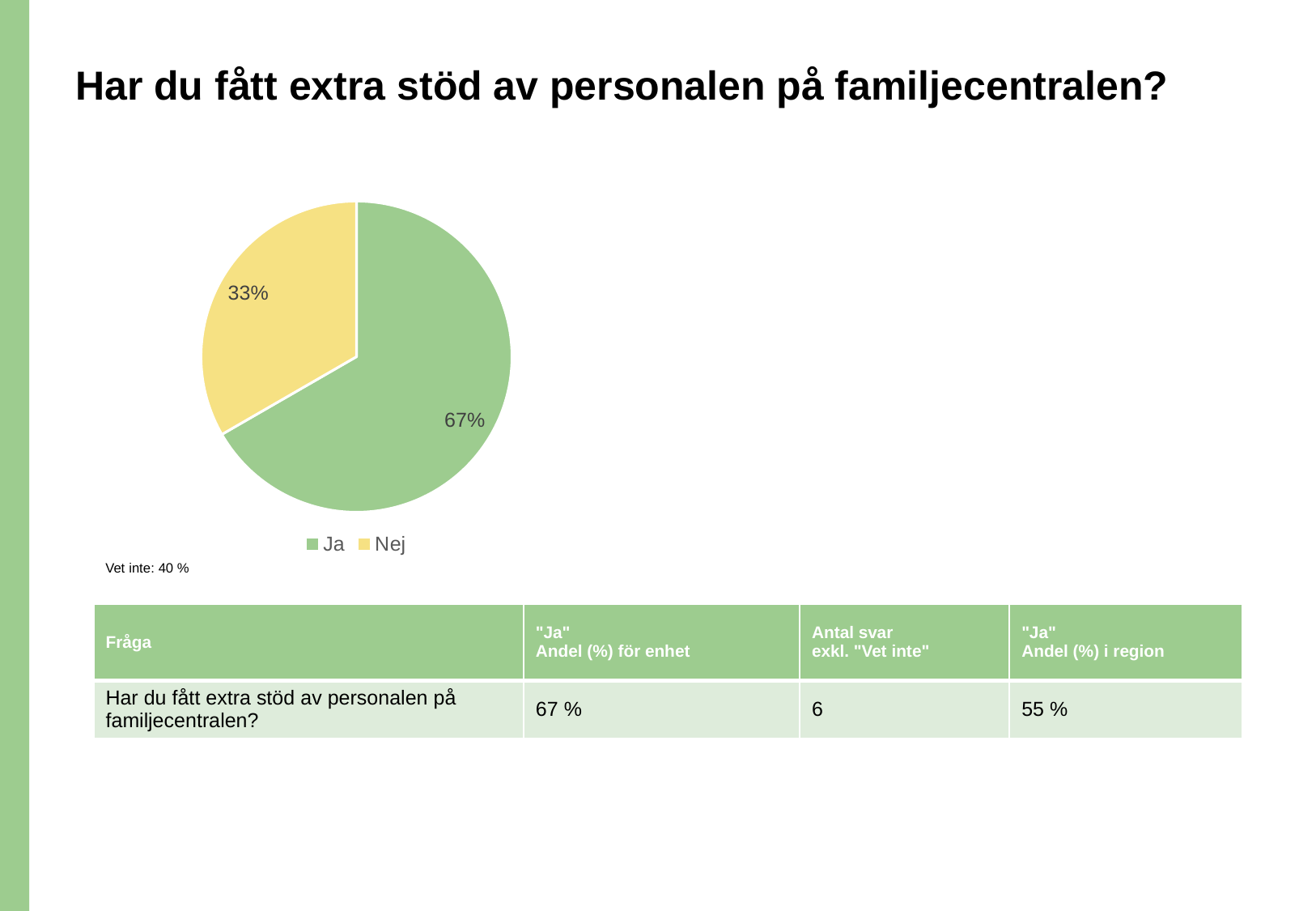
What is the "Vet inte" percentage noted below the pie chart? 40 % What share of the pie chart is labelled "Nej"? 33% How many entries does the legend list? 2 What is the difference in percentage points between the "Ja" and "Nej" slices? 34 What colour is the "Nej" slice in the pie chart? yellow Which slice of the pie chart is the largest? Ja Is the share for "Ja" greater or less than 50%? greater Which is larger in the pie chart, "Ja" or "Nej"? Ja What share of the pie chart is labelled "Ja"? 67% Which slice of the pie chart is the smallest? Nej What kind of chart is shown on the slide? pie chart How many slices does the pie chart have? 2